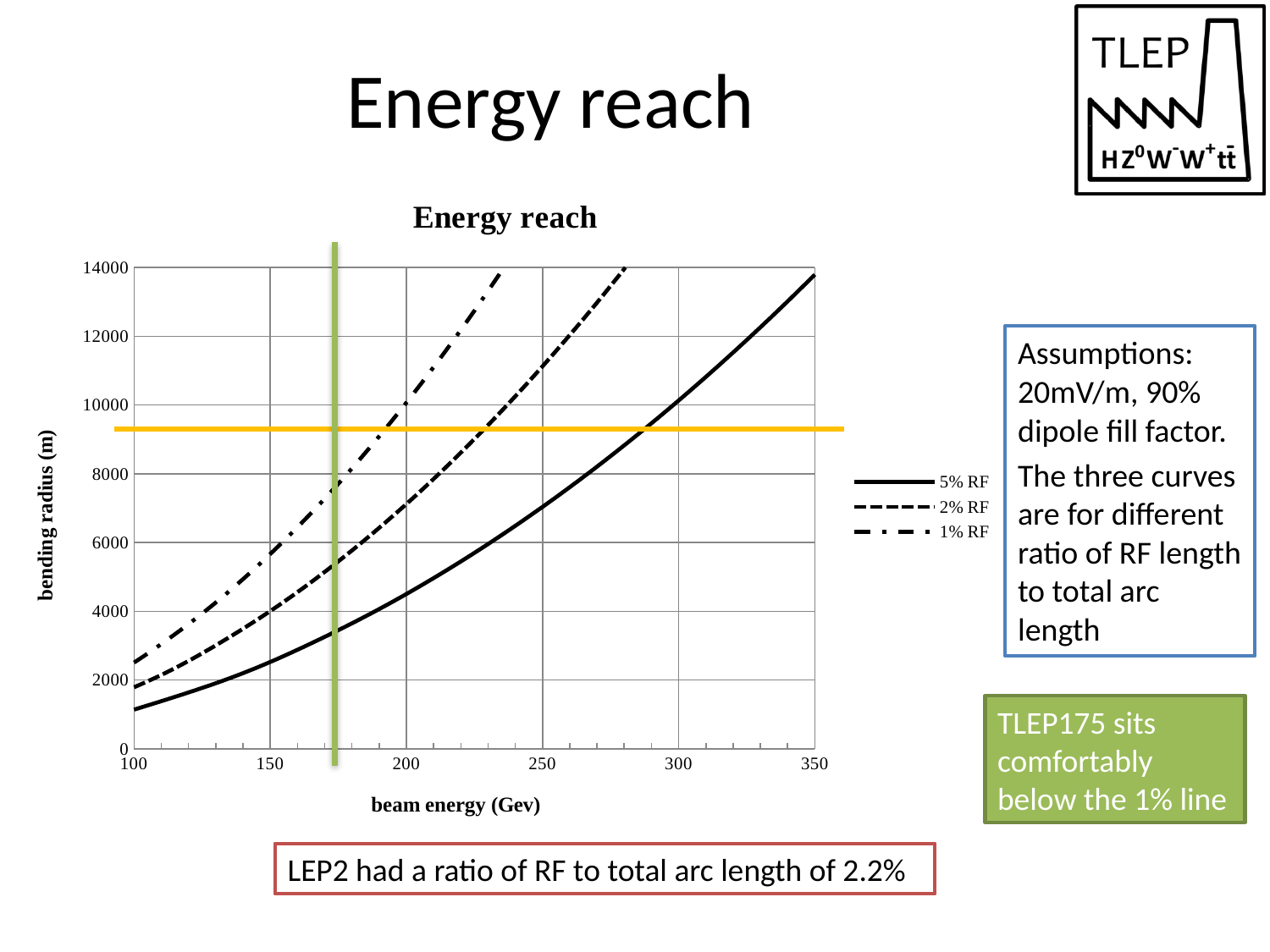
Do the curves in the Energy reach chart rise or fall as beam energy increases? rise What is the label of the x axis of the chart? beam energy (Gev) Is the bending radius for the 5% RF curve at 100 GeV greater or less than 2000? less Is the bending radius for the 1% RF curve at 100 GeV greater or less than 2000? greater At 200 GeV, which curve has the larger bending radius, 1% RF or 5% RF? 1% RF How many series does the legend of the Energy reach chart list? 3 Is the bending radius for the 2% RF curve at 200 GeV greater or less than 6000? greater What kind of chart is shown on the slide? line chart Which series has the highest bending radius at any given beam energy? 1% RF